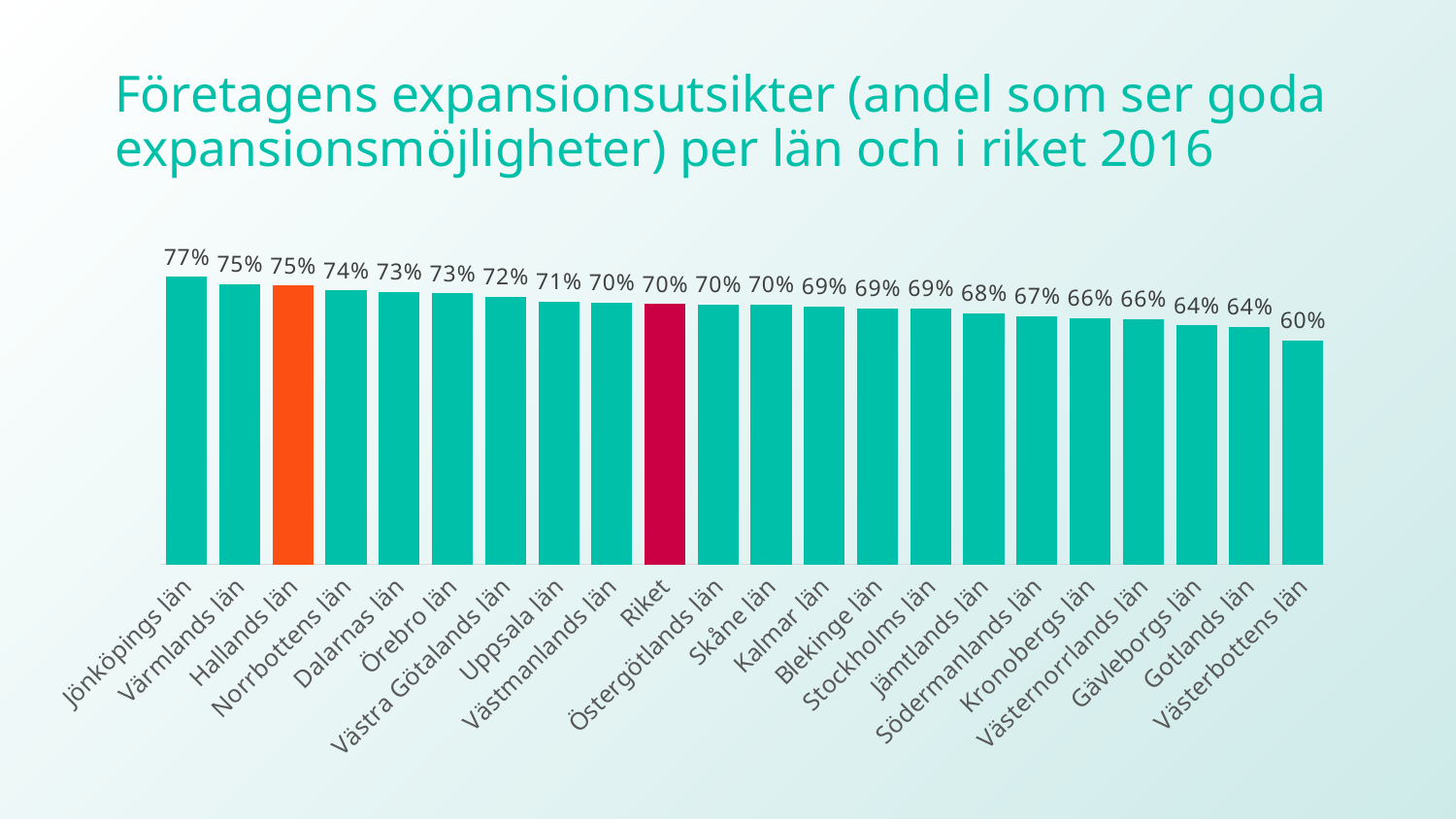
Which category has the highest value? Jönköpings län What is the value for Jönköpings län? 77% Do the values rise or fall from left to right along the x axis? Fall What is the value for Stockholms län? 69% Which category has the lowest value? Västerbottens län How many bars are shown in the chart? 22 What is the difference between the values for Hallands län and Riket? 5% What is the value for Riket? 70% Which is larger, the value for Norrbottens län or the value for Gotlands län? Norrbottens län What is the value for Hallands län? 75% What kind of chart is shown on the slide? Bar chart What is the difference between the values for Jönköpings län and Västerbottens län? 17%